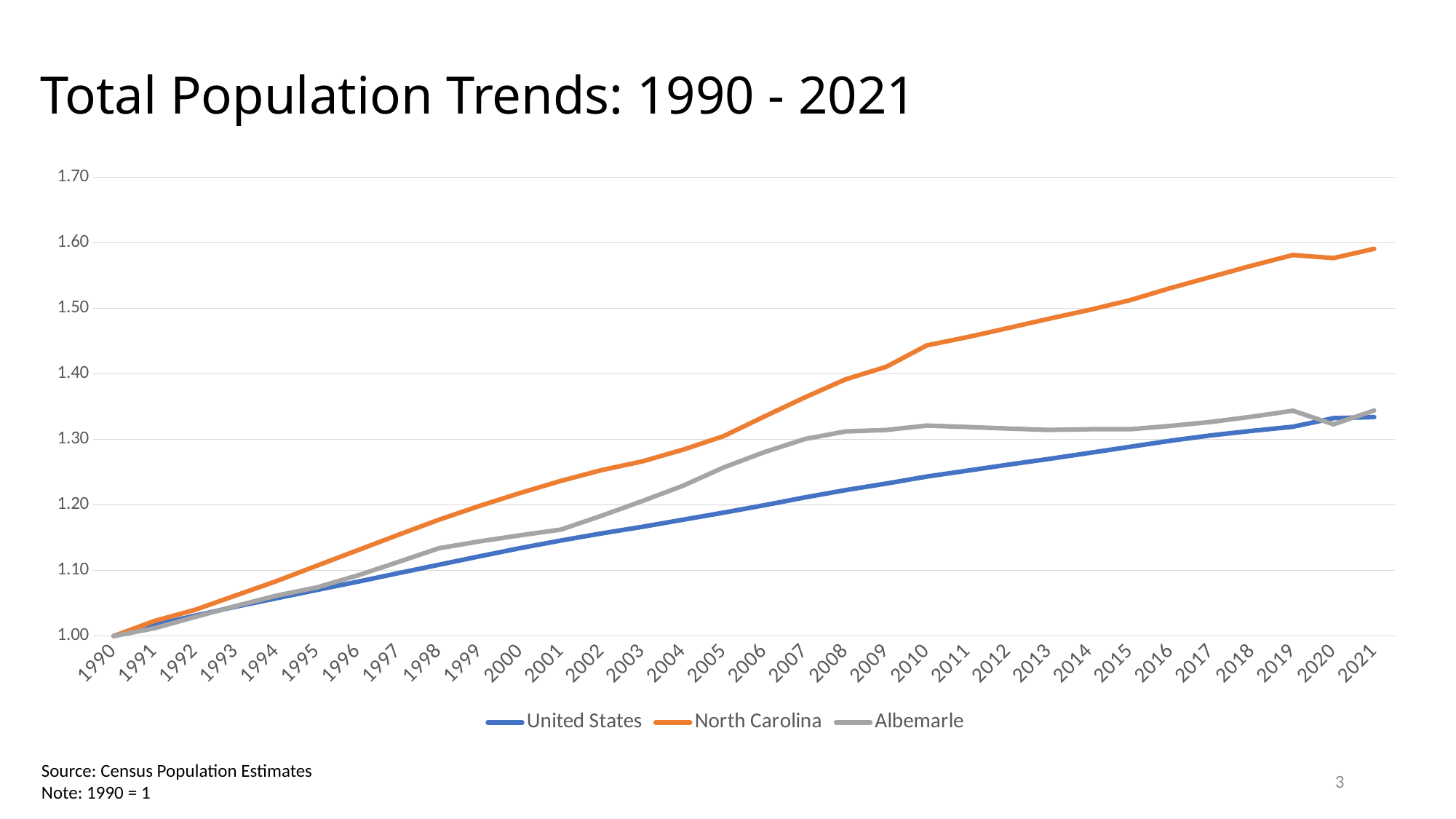
Which is larger in 2015, the value for North Carolina or the value for Albemarle? North Carolina Is the value for United States in 2021 greater or less than 1.40? less What kind of chart is shown on the slide? Line chart What is the value for North Carolina in 1990? 1.00 How many series does the legend list? 3 Is the value for Albemarle in 2000 greater or less than 1.20? less Is the value for North Carolina in 2010 greater or less than 1.40? greater Which series has the highest value in 2021? North Carolina Which series has the lowest value in 2015? United States Does the North Carolina line generally rise or fall from 1990 to 2021? Rise How many years are plotted along the x axis? 32